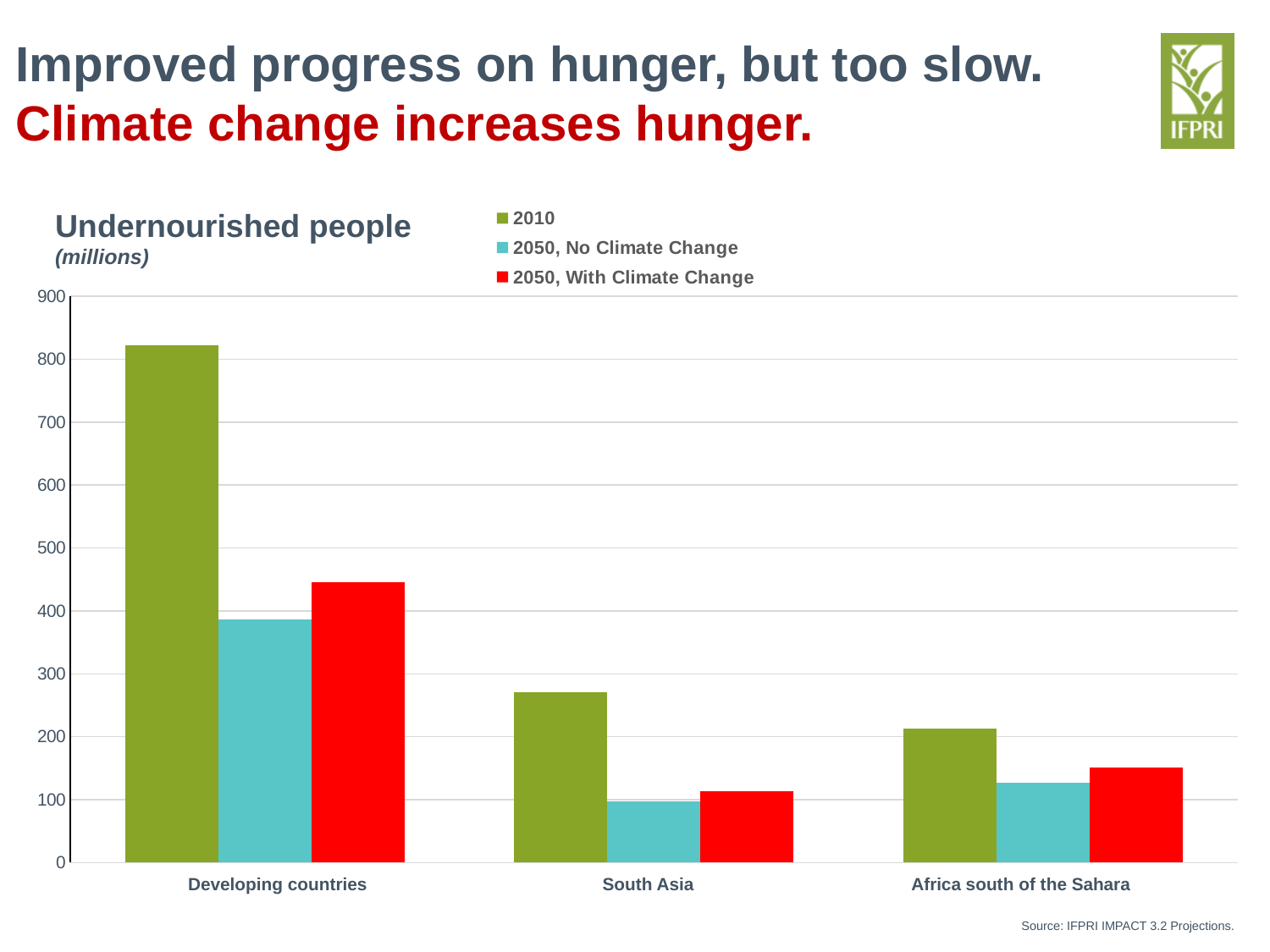
How many series does the legend list? 3 What unit is given in the chart title for undernourished people? millions Which category has the highest 2010 value? Developing countries Which category has the lowest value for 2050, No Climate Change? South Asia How many categories are shown on the x axis? 3 Is the 2050, With Climate Change value for Developing countries greater or less than 400? greater Is the 2010 value for South Asia greater or less than 300? less Is the 2050, With Climate Change value for Africa south of the Sahara greater or less than 100? greater For South Asia, which is larger: the 2050, No Climate Change value or the 2050, With Climate Change value? 2050, With Climate Change Which is larger: the 2010 value for South Asia or the 2010 value for Africa south of the Sahara? South Asia What kind of chart is shown on the slide? bar chart